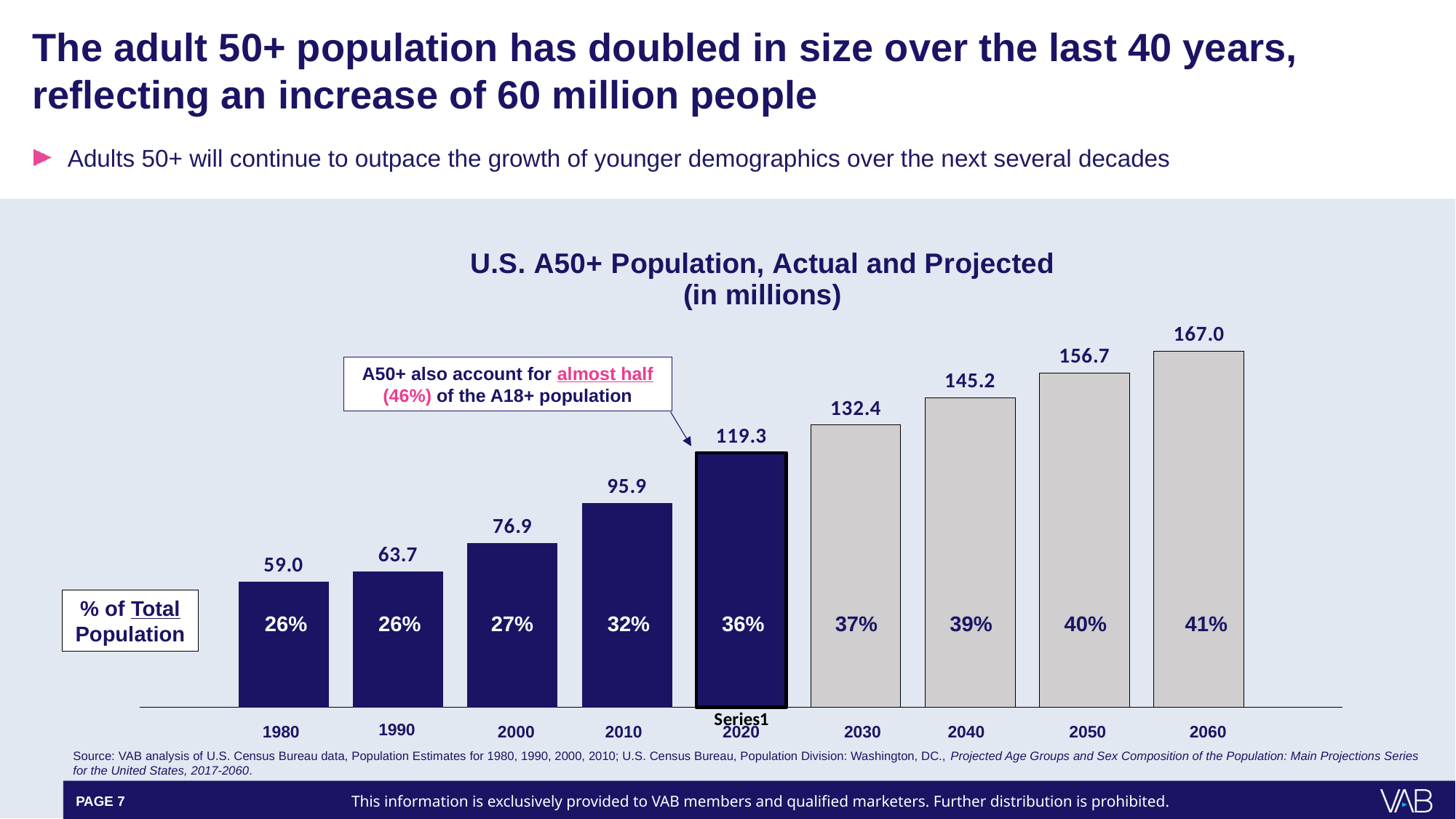
Which year has a larger A50+ population value, 2030 or 2010? 2030 What is the title of the chart on the slide? U.S. A50+ Population, Actual and Projected (in millions) What is the difference between the A50+ population values for 2060 and 2020? 47.7 What kind of chart is used to show the U.S. A50+ Population, Actual and Projected? Bar chart What is the difference between the A50+ population values for 2010 and 2000? 19.0 What is the U.S. A50+ population value shown for 2020? 119.3 Which year has the highest A50+ population value in the chart? 2060 What percentage of the total population do adults 50+ represent in 2060 according to the chart? 41% Which year has the lowest A50+ population value in the chart? 1980 Do the A50+ population values rise or fall from 1980 to 2060? Rise What is the value shown for 1980 in the U.S. A50+ Population chart? 59.0 How many years (bars) are shown in the U.S. A50+ Population chart? 9